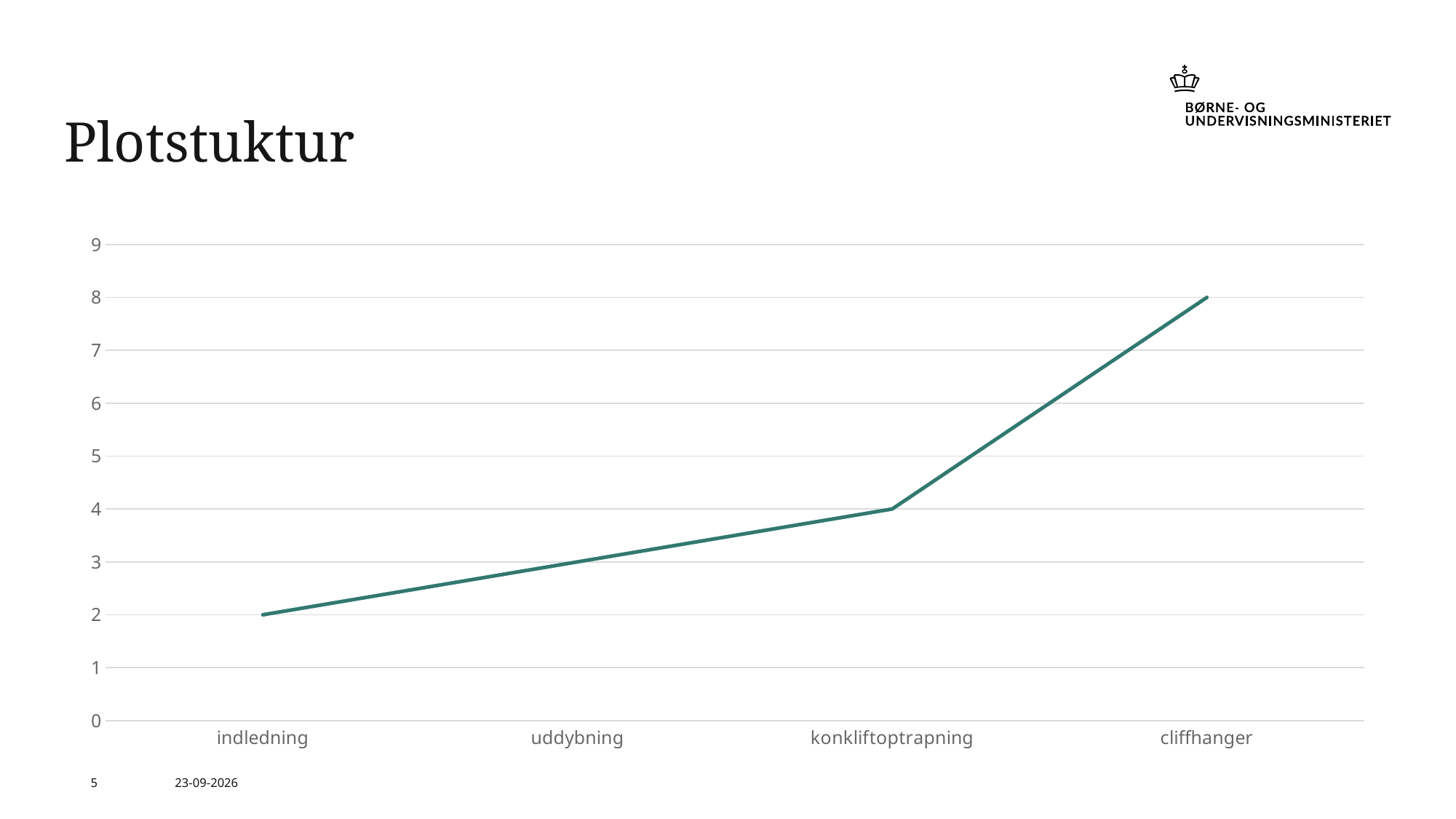
Which category has the highest value? cliffhanger Is the value for uddybning greater or less than 5? less Which category has the lowest value? indledning How many categories are shown on the x axis of the chart? 4 Which is larger, the value for konkliftoptrapning or the value for indledning? konkliftoptrapning What kind of chart is shown on the slide? line chart What is the title of the slide containing the chart? Plotstuktur Do the values rise or fall from indledning to cliffhanger? rise What is the difference between the values for cliffhanger and konkliftoptrapning? 4 What is the value for cliffhanger? 8 What is the value for konkliftoptrapning? 4 What is the value for indledning? 2